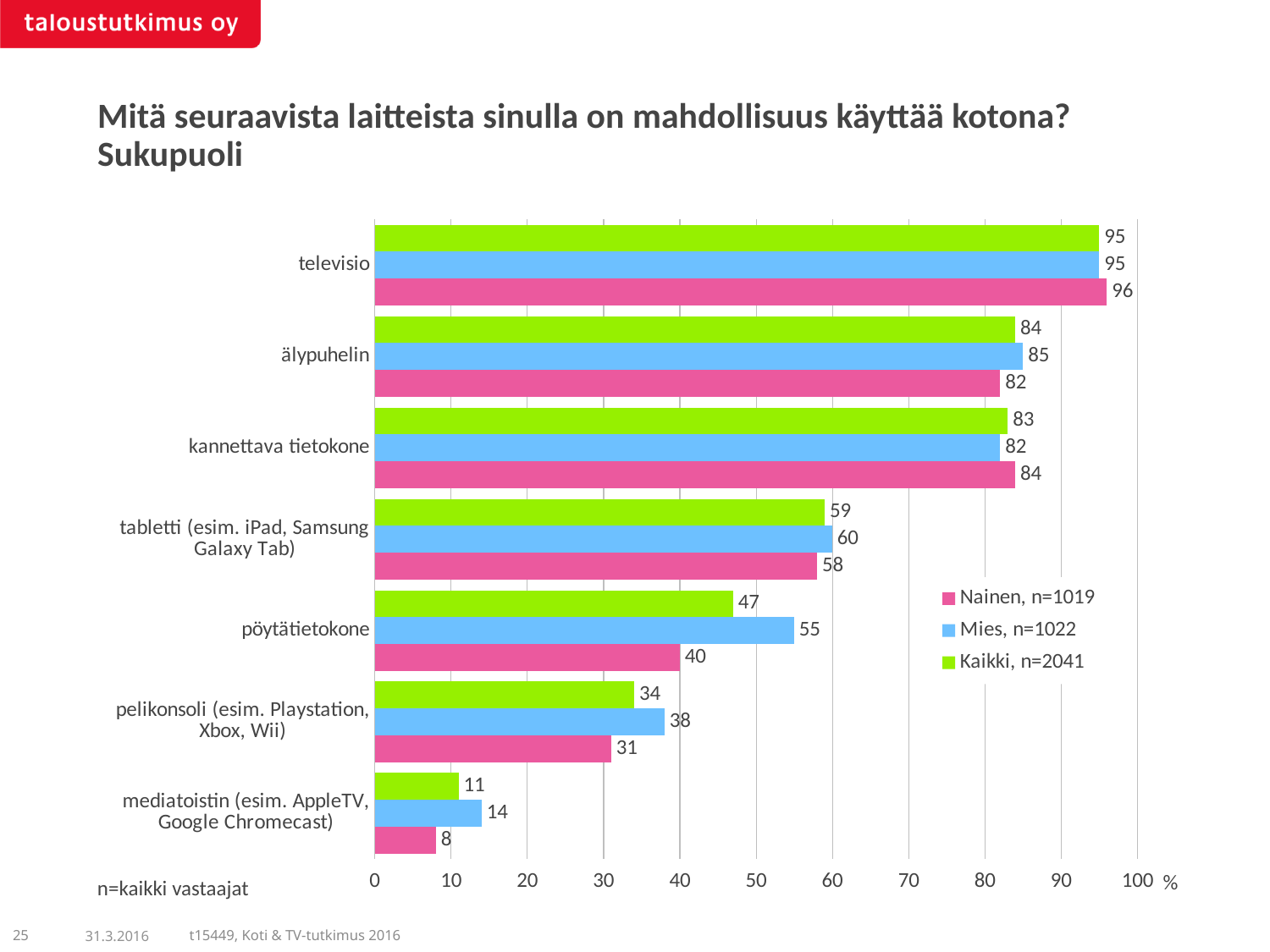
How many series does the legend list? 3 What is the difference between the Mies and Nainen values for pöytätietokone? 15 What is the sample size shown in the legend for Kaikki? n=2041 For pelikonsoli (esim. Playstation, Xbox, Wii), which is larger: the value for Mies or the value for Nainen? Mies Which colour represents the Nainen series? pink What is the value for Kaikki for tabletti (esim. iPad, Samsung Galaxy Tab)? 59 What kind of chart is shown on the slide? bar chart Which category has the lowest value for Mies? mediatoistin (esim. AppleTV, Google Chromecast) What is the value for Mies for pöytätietokone? 55 How many device categories are shown on the chart? 7 What is the value for Nainen for mediatoistin (esim. AppleTV, Google Chromecast)? 8 Which category has the highest value for Kaikki? televisio